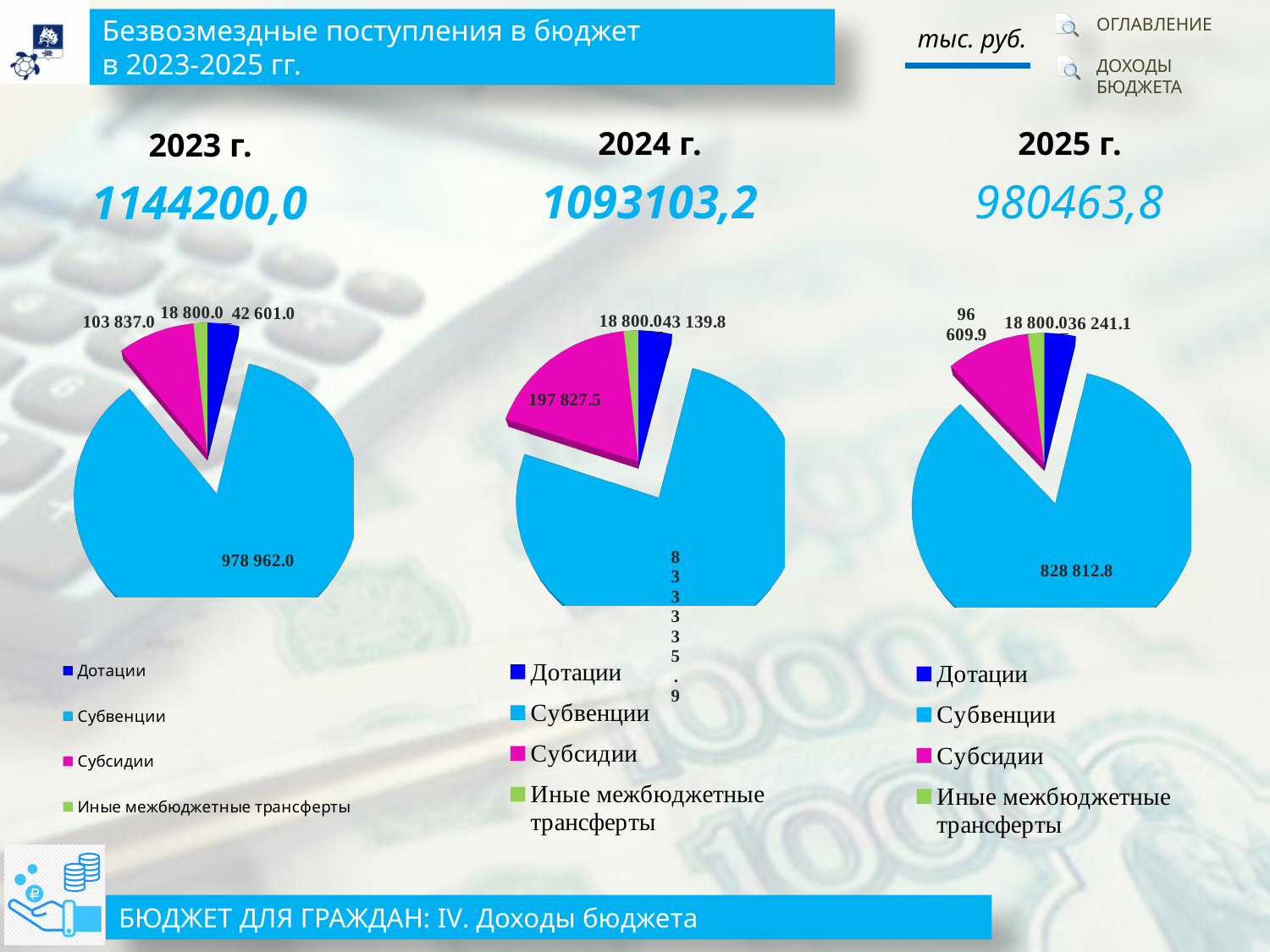
In the 2024 г. pie chart, what is the value for Субсидии? 197 827.5 In the 2023 г. pie chart, what is the value for Дотации? 42 601.0 How many categories does the legend of the 2024 г. pie chart list? 4 In the 2023 г. pie chart, what is the value for Субсидии? 103 837.0 In the 2023 г. pie chart, what is the value for Субвенции? 978 962.0 In the 2025 г. pie chart, what is the value for Субвенции? 828 812.8 How many pie charts are on the slide? 3 In the 2025 г. pie chart, what is the value for Субсидии? 96 609.9 In the 2024 г. pie chart, what is the value for Дотации? 43 139.8 In the 2023 г. pie chart, what is the difference between Субсидии and Дотации? 61 236.0 What type of charts are shown on the slide? Pie charts In the 2025 г. pie chart, which category has the largest slice? Субвенции